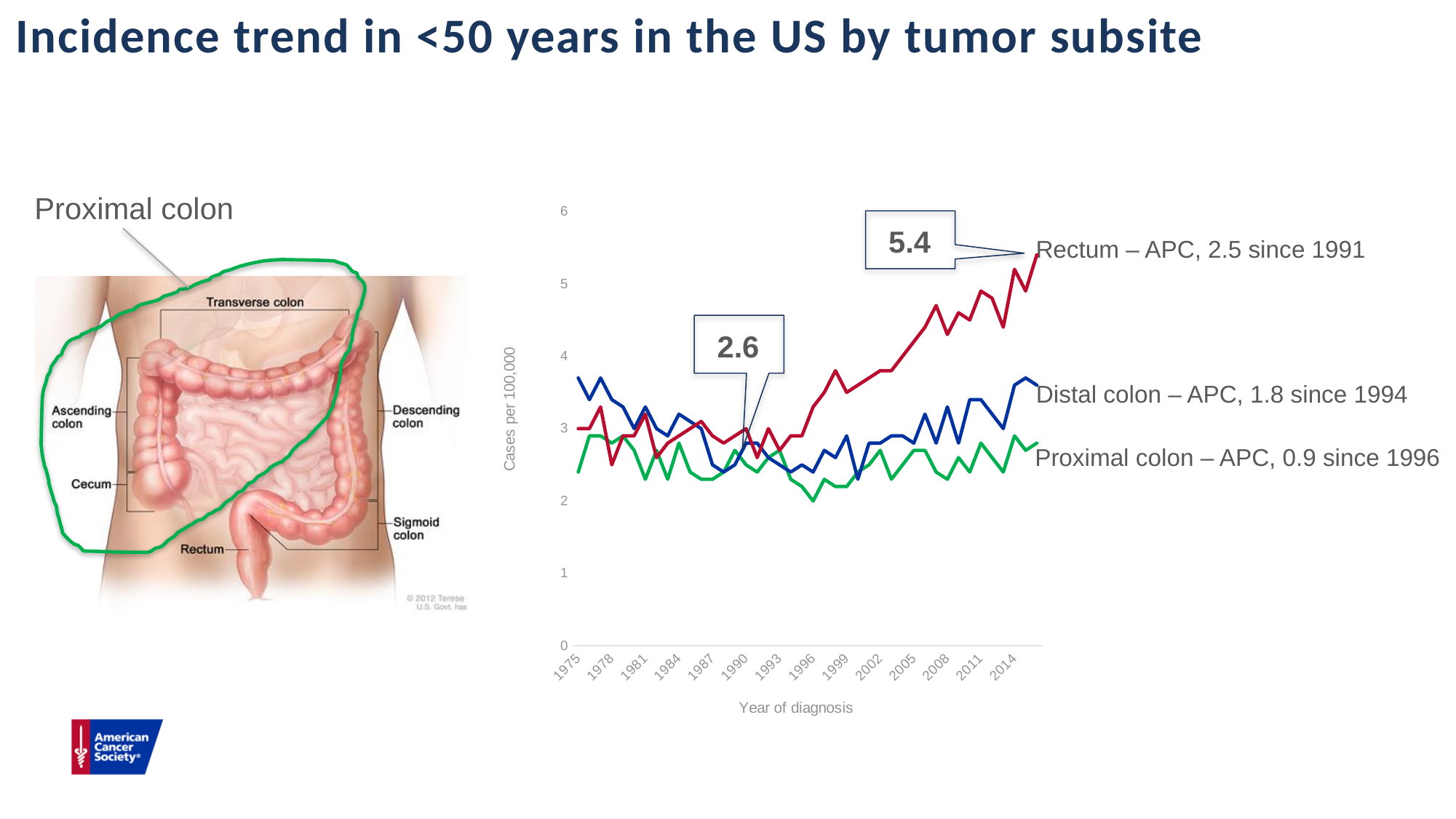
What kind of chart is shown on the slide? line chart Is the value for Proximal colon in 1996 greater or less than 3? less What is the labeled value on the Rectum line around 1991? 2.6 Which tumor subsite has the lowest incidence at the end of the period shown? Proximal colon Is the value for Rectum in 2002 greater or less than 3? greater In 1975, which is higher, Distal colon or Proximal colon? Distal colon Which tumor subsite has the highest incidence at the end of the period shown? Rectum What is the label on the y axis of the chart? Cases per 100,000 Does the Rectum line rise or fall from 1991 to the end of the period? rise What is the difference between the two labeled values on the Rectum line, 5.4 and 2.6? 2.8 What is the labeled value at the end of the Rectum line? 5.4 How many series are plotted on the chart? 3